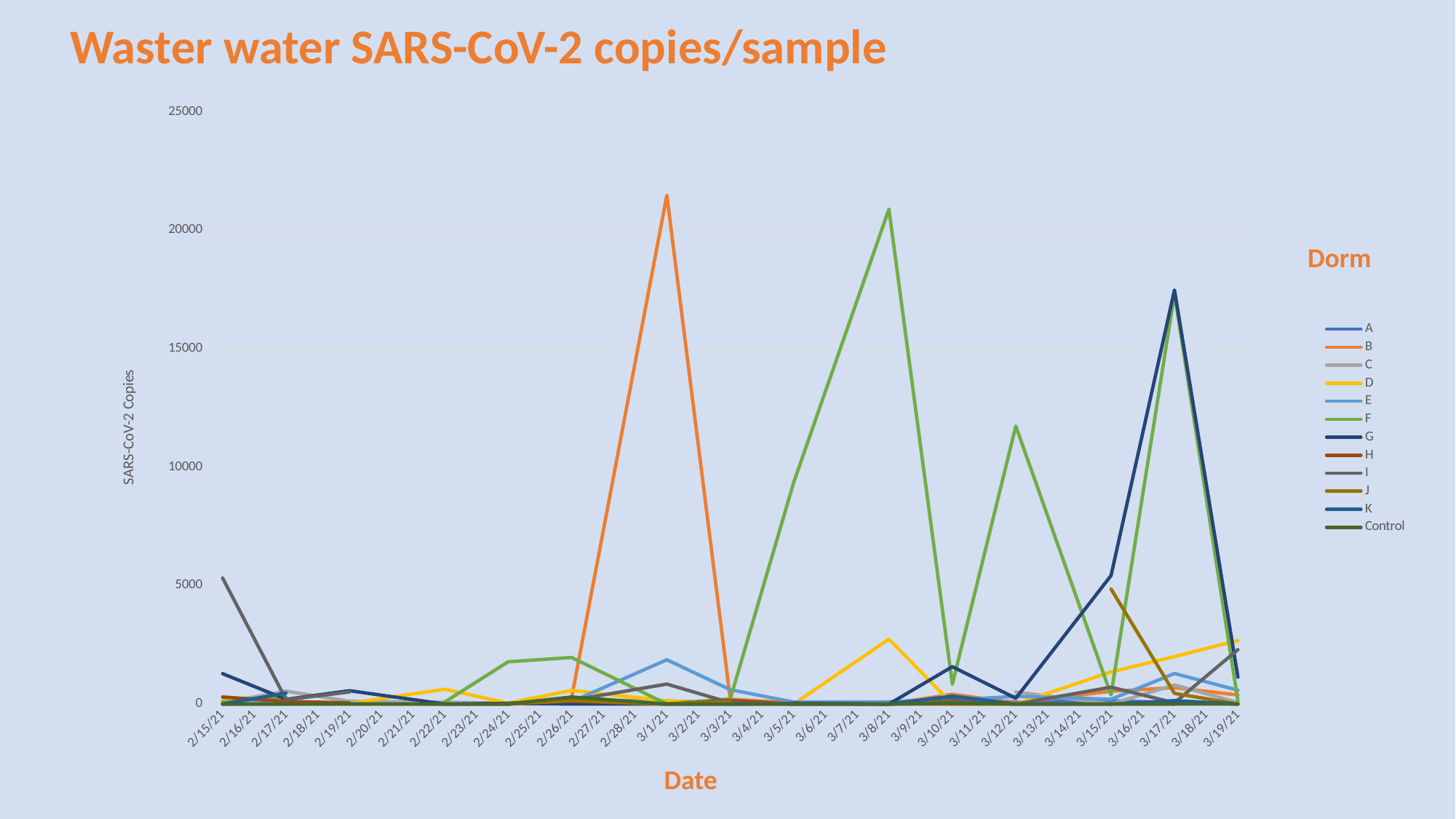
Is the value for dorm F on 3/8/21 greater or less than 20000? greater What is the title of the legend? Dorm Is the value for dorm B on 3/1/21 greater or less than 20000? greater Which is larger: the value for dorm B on 3/1/21 or the value for dorm F on 3/12/21? dorm B on 3/1/21 Is the value for dorm D on 3/8/21 greater or less than 5000? less Which is larger: the value for dorm F on 3/8/21 or the value for dorm G on 3/17/21? dorm F on 3/8/21 What is the title of the chart? Waster water SARS-CoV-2 copies/sample How many dates are shown on the x axis? 33 How many series does the legend list? 12 What kind of chart is shown on the slide? line chart